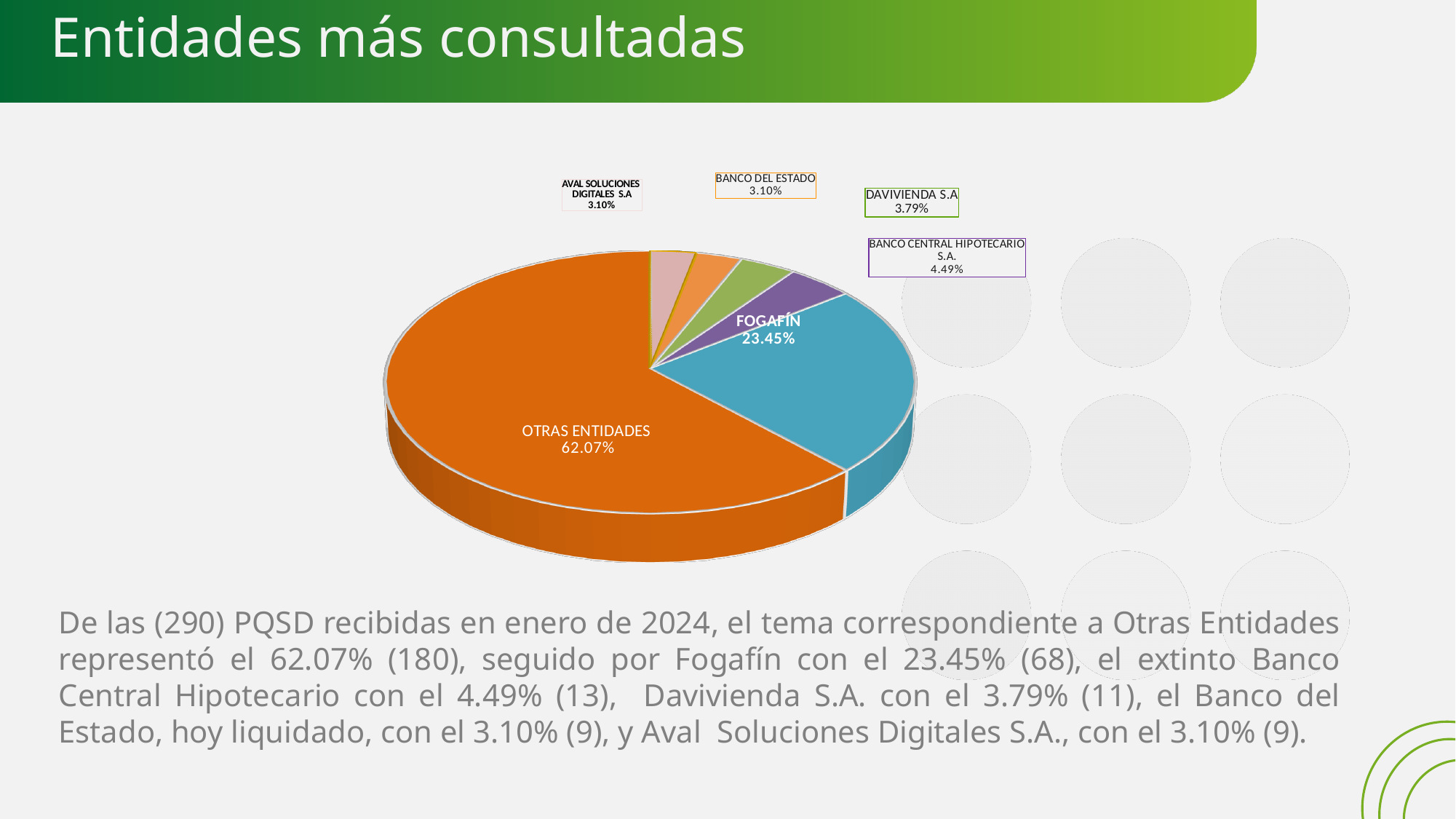
How many slices does the pie chart have? 6 What kind of chart is shown on the slide? pie chart What percentage is shown for BANCO DEL ESTADO? 3.10% Which entity has the second-largest slice of the pie? FOGAFÍN What is the title of the slide containing the pie chart? Entidades más consultadas What is the difference in percentage points between OTRAS ENTIDADES and FOGAFÍN? 38.62% What percentage is shown for DAVIVIENDA S.A? 3.79% What percentage is shown for BANCO CENTRAL HIPOTECARIO S.A.? 4.49% What percentage is shown for FOGAFÍN? 23.45% Which is larger, the share for DAVIVIENDA S.A or the share for BANCO CENTRAL HIPOTECARIO S.A.? BANCO CENTRAL HIPOTECARIO S.A. What share of the pie does OTRAS ENTIDADES represent? 62.07% Which entity has the largest slice of the pie? OTRAS ENTIDADES